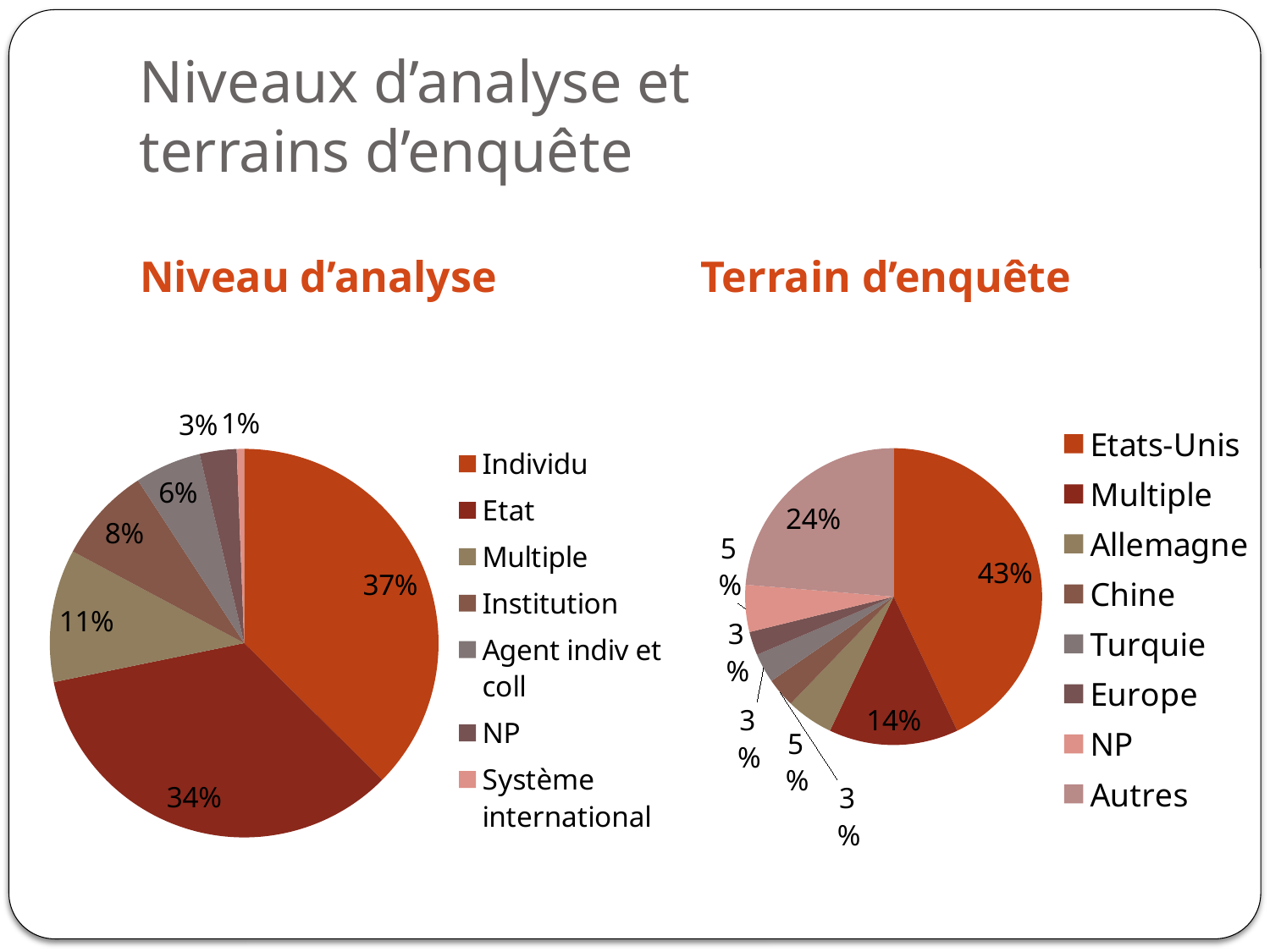
In the 'Niveau d'analyse' pie chart, which category has the smallest share? Système international In the 'Terrain d'enquête' pie chart, which is larger, Multiple or Autres? Autres In the 'Terrain d'enquête' pie chart, what share does Autres have? 24% In the 'Niveau d'analyse' pie chart, which category has the largest share? Individu In the 'Terrain d'enquête' pie chart, what share does Etats-Unis have? 43% How many categories does the legend of the 'Niveau d'analyse' chart list? 7 In the 'Niveau d'analyse' pie chart, what is the difference between the shares of Individu and Etat? 3% In the 'Niveau d'analyse' pie chart, what share does Etat have? 34% What type of chart is used for 'Terrain d'enquête'? Pie chart In the 'Niveau d'analyse' pie chart, what share does Multiple have? 11% In the 'Terrain d'enquête' pie chart, what share does Multiple have? 14% In the 'Niveau d'analyse' pie chart, what share does Individu have? 37%